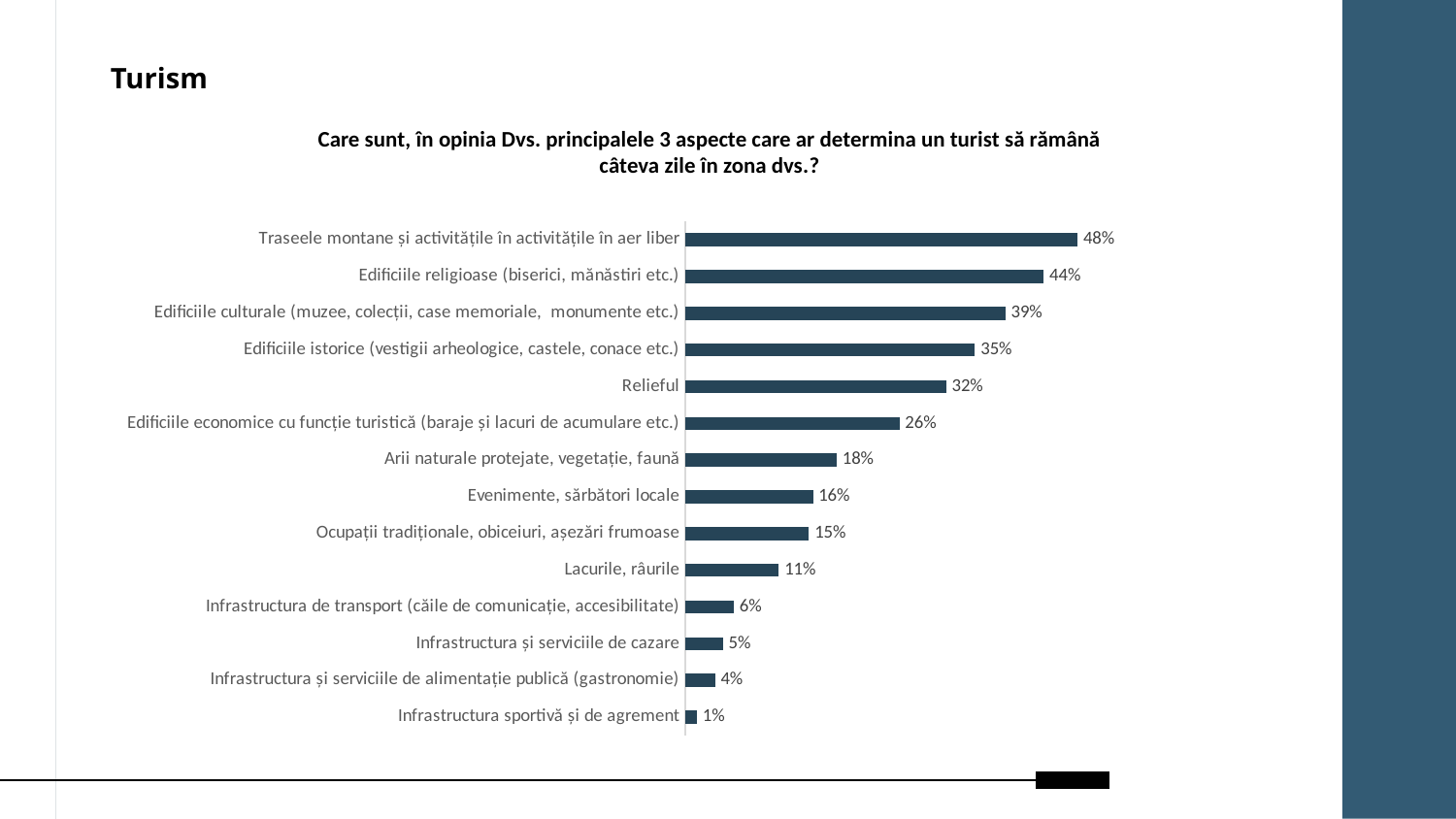
What kind of chart is shown on the slide? Bar chart Which category has the highest value? Traseele montane și activitățile în activitățile în aer liber What is the value for "Relieful"? 32% How many categories are shown in the chart? 14 What is the value for "Lacurile, râurile"? 11% What is the title of the chart? Care sunt, în opinia Dvs. principalele 3 aspecte care ar determina un turist să rămână câteva zile în zona dvs.? What is the difference between the values for "Edificiile culturale (muzee, colecții, case memoriale, monumente etc.)" and "Edificiile istorice (vestigii arheologice, castele, conace etc.)"? 4% What is the value for "Edificiile religioase (biserici, mănăstiri etc.)"? 44% Which is larger: the value for "Evenimente, sărbători locale" or the value for "Arii naturale protejate, vegetație, faună"? Arii naturale protejate, vegetație, faună What is the difference between the values for "Infrastructura de transport (căile de comunicație, accesibilitate)" and "Infrastructura și serviciile de cazare"? 1% What is the value for "Edificiile economice cu funcție turistică (baraje și lacuri de acumulare etc.)"? 26% Which category has the lowest value? Infrastructura sportivă și de agrement